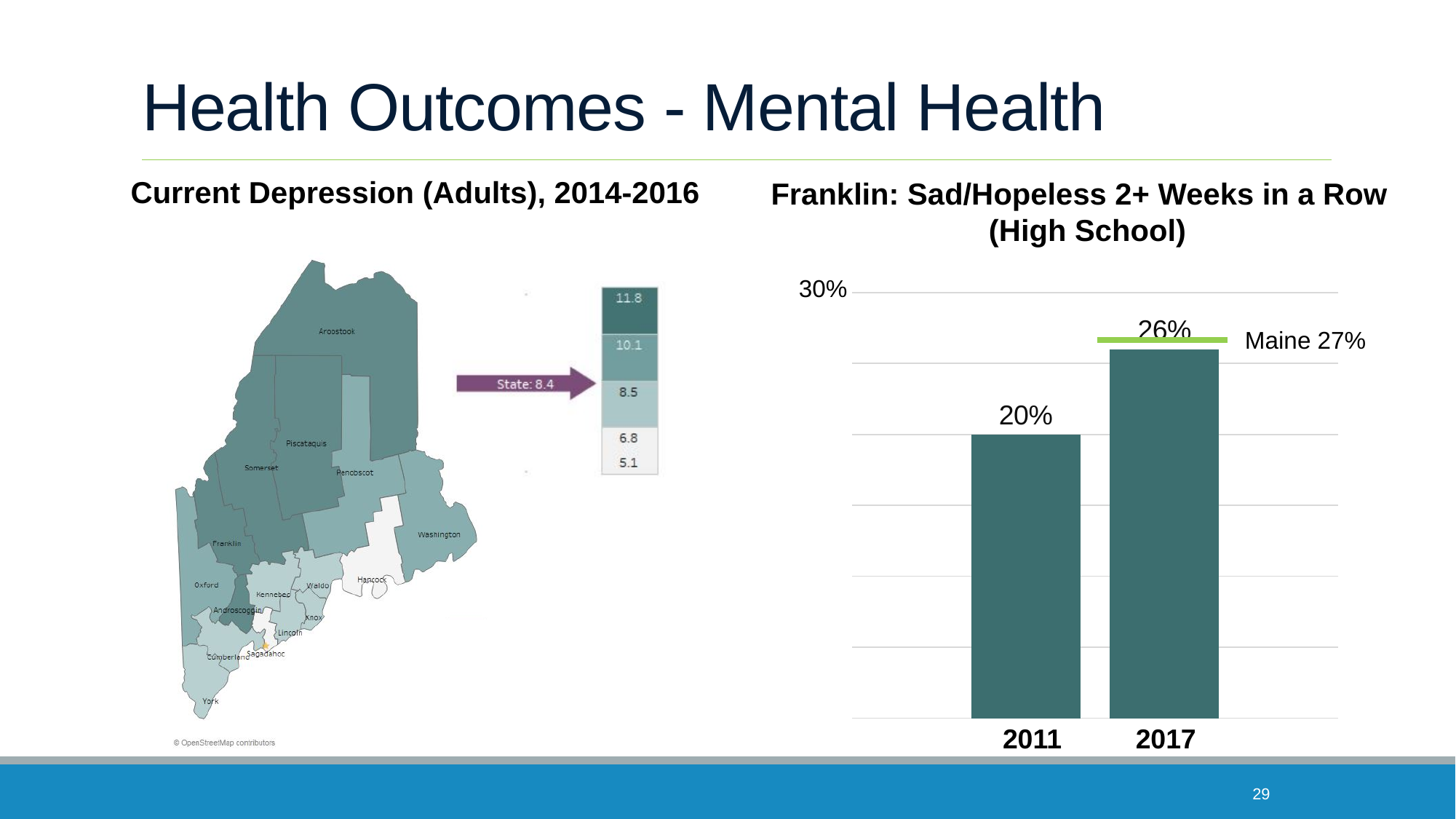
On the bar chart 'Franklin: Sad/Hopeless 2+ Weeks in a Row (High School)', which year has the lower value? 2011 What kind of chart is 'Franklin: Sad/Hopeless 2+ Weeks in a Row (High School)'? bar chart On the bar chart 'Franklin: Sad/Hopeless 2+ Weeks in a Row (High School)', is the 2017 Franklin value larger or smaller than the Maine value? smaller On the bar chart 'Franklin: Sad/Hopeless 2+ Weeks in a Row (High School)', what is the Maine value shown by the green reference line? 27% On the bar chart 'Franklin: Sad/Hopeless 2+ Weeks in a Row (High School)', by how many percentage points did the value increase from 2011 to 2017? 6 percentage points On the bar chart 'Franklin: Sad/Hopeless 2+ Weeks in a Row (High School)', does the value rise or fall from 2011 to 2017? rise How many bars are shown on the bar chart 'Franklin: Sad/Hopeless 2+ Weeks in a Row (High School)'? 2 On the bar chart 'Franklin: Sad/Hopeless 2+ Weeks in a Row (High School)', what is the value for 2011? 20% On the bar chart 'Franklin: Sad/Hopeless 2+ Weeks in a Row (High School)', what is the value for 2017? 26% On the map 'Current Depression (Adults), 2014-2016', what is the state value shown by the purple arrow? 8.4 On the bar chart 'Franklin: Sad/Hopeless 2+ Weeks in a Row (High School)', which year has the higher value? 2017 On the bar chart 'Franklin: Sad/Hopeless 2+ Weeks in a Row (High School)', is the value for 2017 greater or less than 30%? less